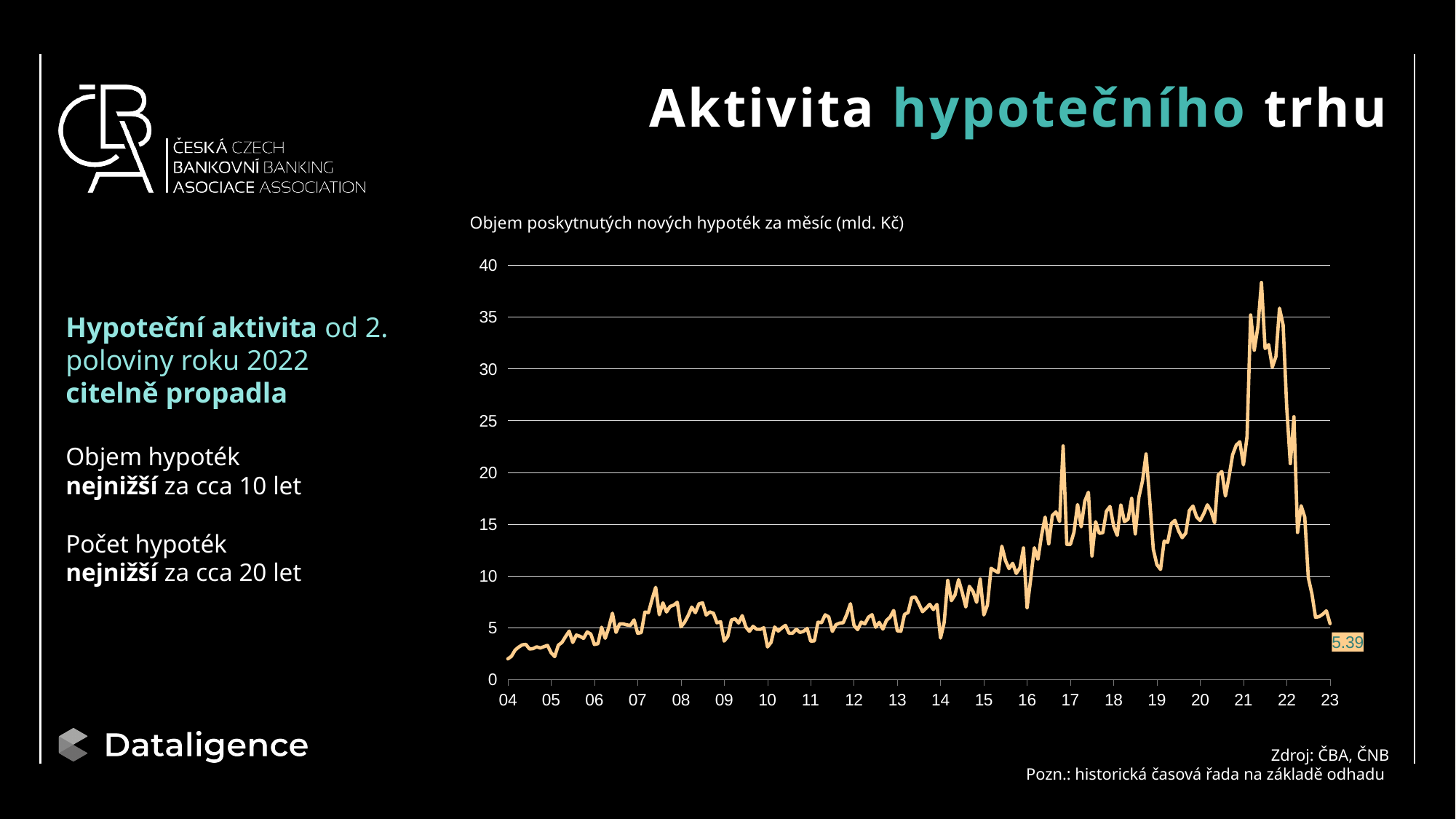
How many year labels are shown on the x axis? 20 What is the highest value shown on the y axis? 40 In which year does the line reach its highest peak? 2021 How does the line move from 2022 to 2023? it falls sharply What is the last data value labelled on the chart, at the end of the series in 2023? 5.39 What kind of chart is shown on the slide? line chart Which is larger: the peak in 2021 or the peak in 2017? the peak in 2021 Is the value at the start of the series in 2004 greater or less than 5? less Is the highest peak of the line (in 2021) greater or less than 35? greater What is the title of the chart? Objem poskytnutých nových hypoték za měsíc (mld. Kč) Is the value in 2008 greater or less than 10? less